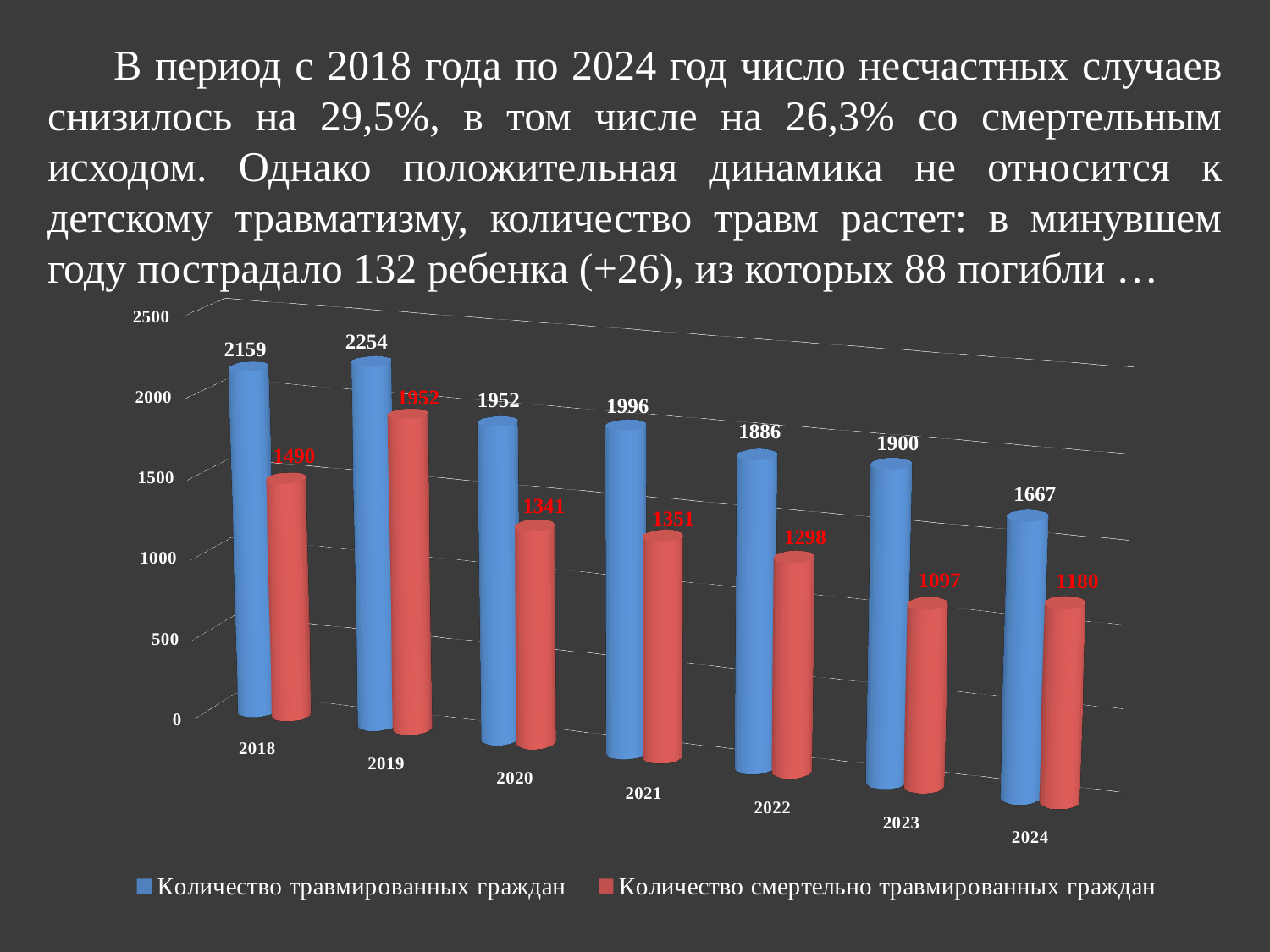
Which colour represents "Количество смертельно травмированных граждан" in the legend? Red In which year is "Количество травмированных граждан" highest? 2019 What kind of chart is shown on the slide? Bar chart What is the value for "Количество травмированных граждан" in 2019? 2254 Does "Количество травмированных граждан" rise or fall from 2019 to 2024? Fall What is the difference between "Количество травмированных граждан" and "Количество смертельно травмированных граждан" in 2018? 669 In which year is "Количество смертельно травмированных граждан" lowest? 2023 What is the value for "Количество смертельно травмированных граждан" in 2023? 1097 Which is larger: "Количество смертельно травмированных граждан" in 2020 or in 2021? 2021 What is the value for "Количество травмированных граждан" in 2024? 1667 How many years are shown on the x axis? 7 How many series does the legend list? 2